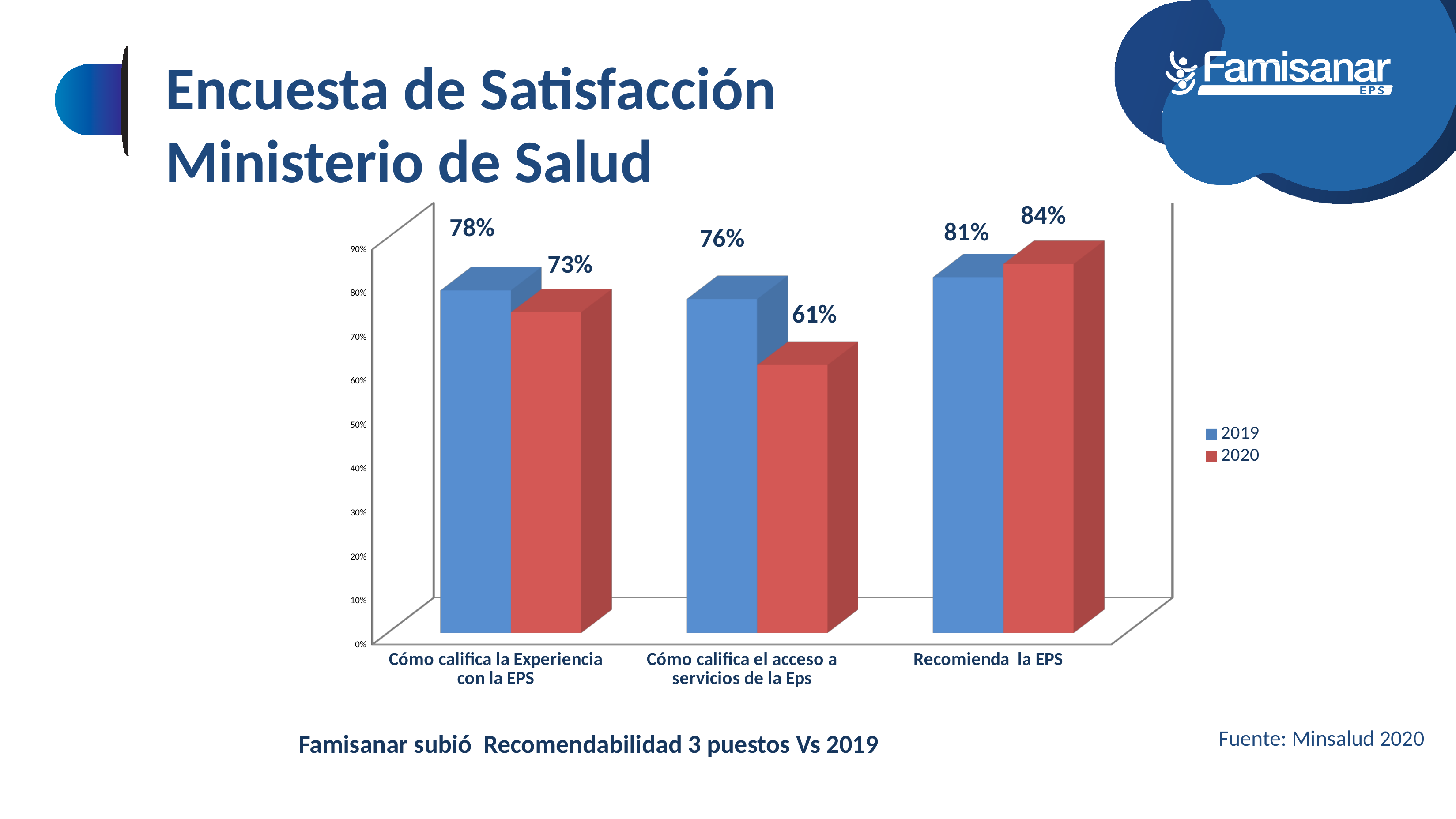
What is the 2020 value for "Recomienda la EPS"? 84% What is the 2019 value for "Cómo califica la Experiencia con la EPS"? 78% Is the 2020 value for "Cómo califica la Experiencia con la EPS" greater or less than 70%? greater What is the 2020 value for "Cómo califica el acceso a servicios de la Eps"? 61% For "Recomienda la EPS", which year has the larger value, 2019 or 2020? 2020 Which colour represents the 2020 series in the legend? Red How many categories are shown on the x axis? 3 What is the difference between the 2019 and 2020 values for "Cómo califica el acceso a servicios de la Eps"? 15% How many series does the legend list? 2 What kind of chart is shown on the slide? Bar chart Which category has the highest 2020 value? Recomienda la EPS Which category has the lowest 2020 value? Cómo califica el acceso a servicios de la Eps